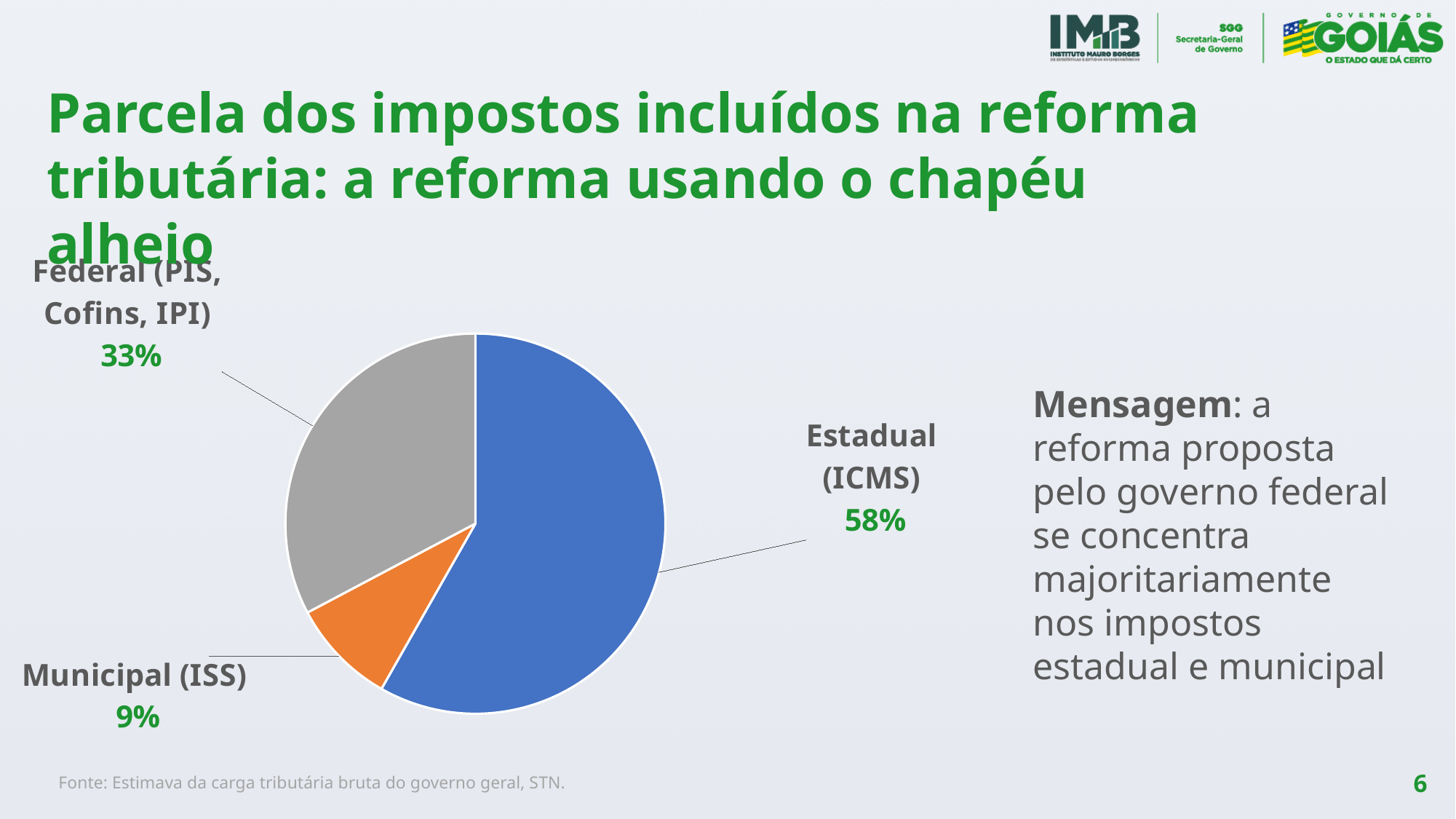
What kind of chart is shown on the slide? Pie chart What share of the pie does Estadual (ICMS) represent? 58% What colour is the Municipal (ISS) slice? Orange What is the difference in percentage points between the Estadual (ICMS) and Federal (PIS, Cofins, IPI) slices? 25 percentage points What share of the pie does Municipal (ISS) represent? 9% What share of the pie does Federal (PIS, Cofins, IPI) represent? 33% Which category has the largest slice of the pie? Estadual (ICMS) Which category has the smallest slice of the pie? Municipal (ISS) How many slices does the pie chart have? 3 Which is larger, the Federal (PIS, Cofins, IPI) slice or the Municipal (ISS) slice? Federal (PIS, Cofins, IPI) What is the difference in percentage points between the Federal (PIS, Cofins, IPI) and Municipal (ISS) slices? 24 percentage points What colour is the Estadual (ICMS) slice? Blue